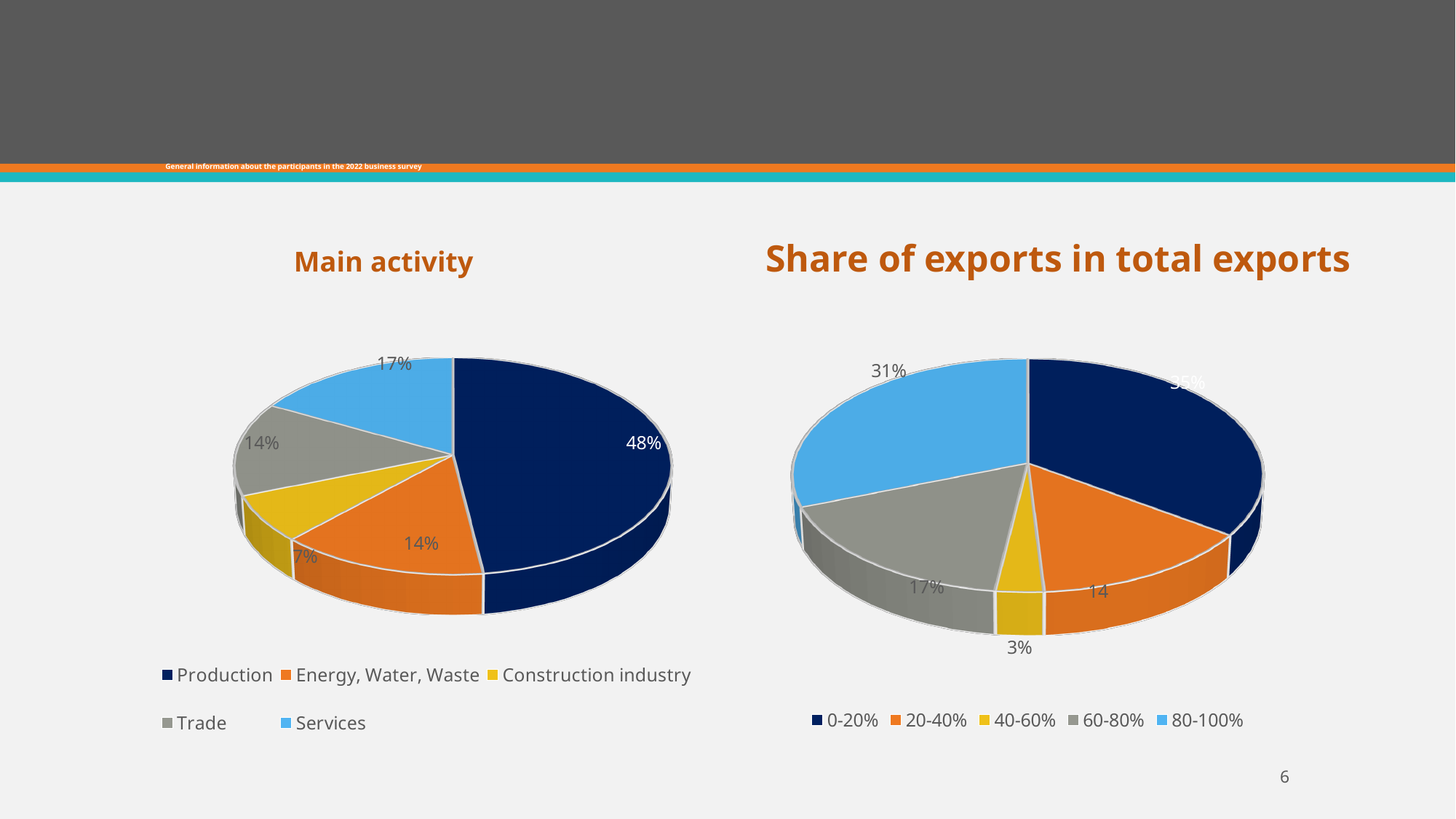
In the 'Main activity' chart, which category has the smallest slice? Construction industry In the 'Main activity' chart, what share does Construction industry have? 7% In the 'Main activity' chart, what share does Production have? 48% In the 'Share of exports in total exports' chart, what share does the 0-20% category have? 35% In the 'Main activity' chart, which category has the largest slice? Production In the 'Share of exports in total exports' chart, which is larger, the 60-80% slice or the 80-100% slice? 80-100% In the 'Main activity' chart, what share does Services have? 17% In the 'Share of exports in total exports' chart, which category has the smallest slice? 40-60% In the 'Main activity' chart, what is the difference between the Production share and the Services share? 31% In the 'Main activity' chart, how many categories does the legend list? 5 What type of chart is the 'Share of exports in total exports' chart? Pie chart In the 'Share of exports in total exports' chart, what share does the 80-100% category have? 31%